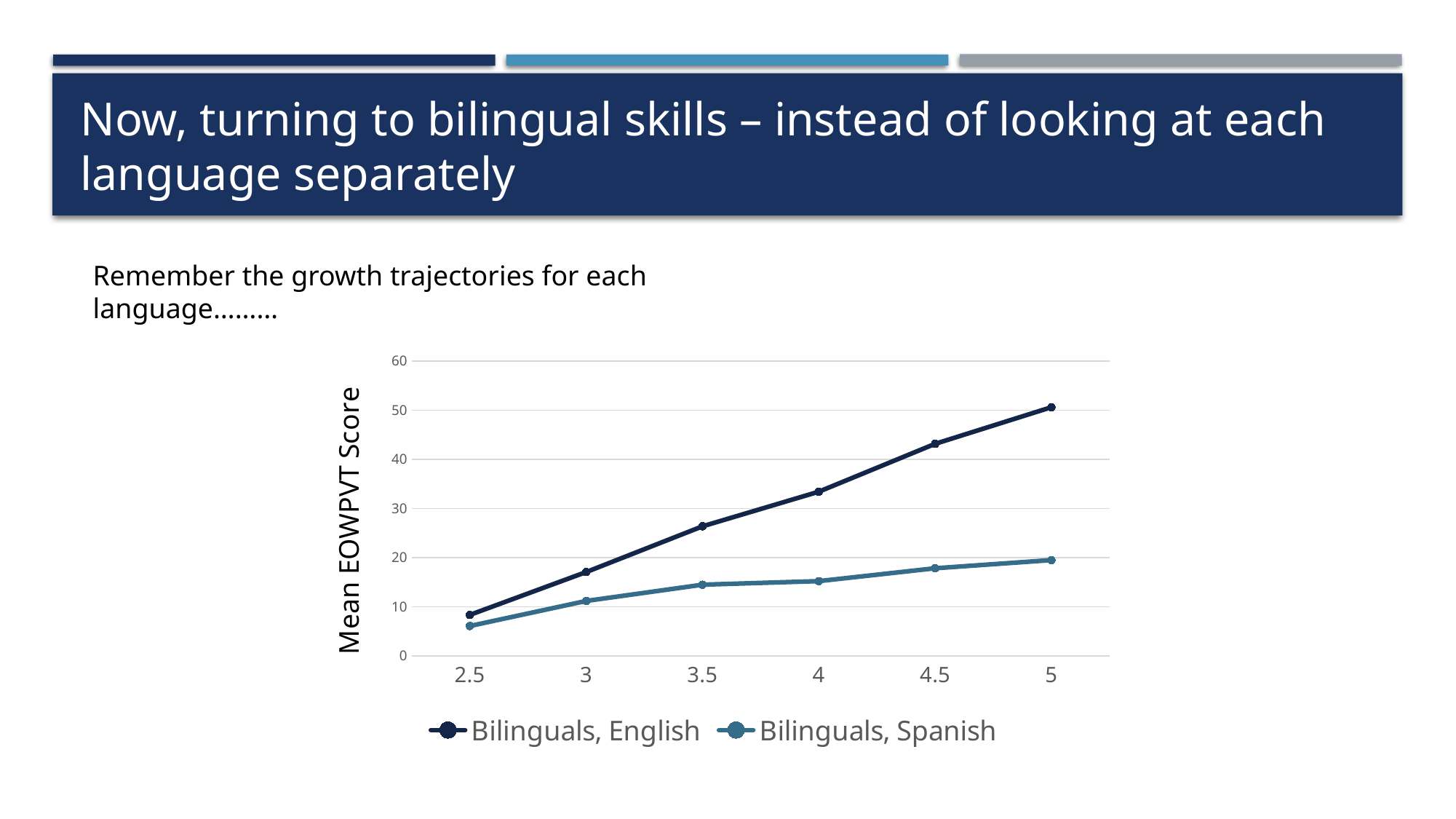
Is the value for Bilinguals, English at x = 4.5 greater or less than 40? greater Do the values for Bilinguals, English rise or fall as the x axis goes from 2.5 to 5? rise What is the label on the vertical axis of the chart? Mean EOWPVT Score At which x value does the Bilinguals, Spanish series have its lowest point? 2.5 Is the value for Bilinguals, English at x = 3.5 greater or less than 30? less What kind of chart is shown on the slide? line chart Do the values for Bilinguals, Spanish rise or fall as the x axis goes from 2.5 to 5? rise At which x value does the Bilinguals, English series reach its highest point? 5 How many series does the legend list? 2 Is the value for Bilinguals, Spanish at x = 2.5 greater or less than 10? less At x = 5, which series has the larger value, Bilinguals, English or Bilinguals, Spanish? Bilinguals, English How many points are plotted along the x axis for each series? 6